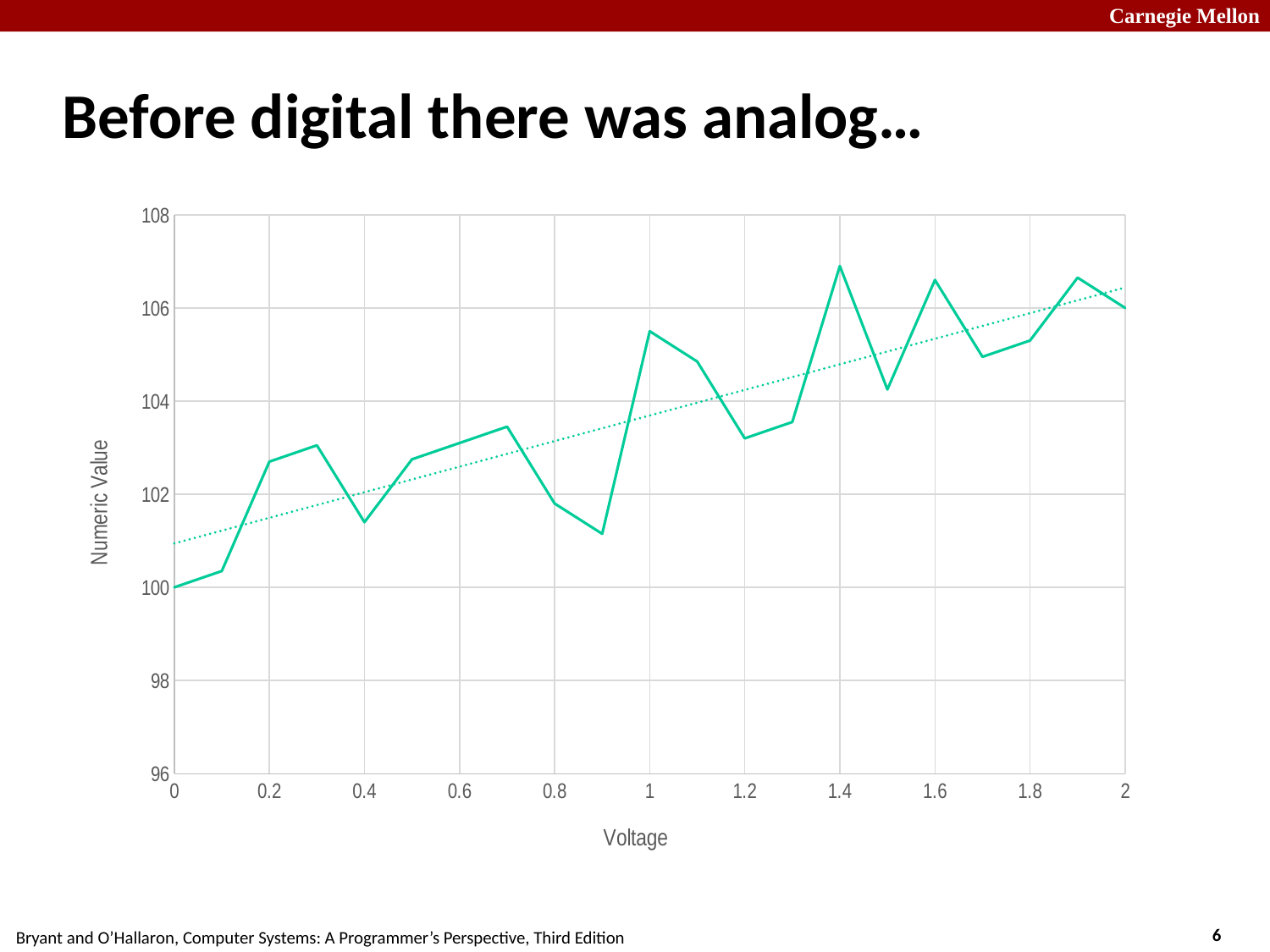
What is the Numeric Value at Voltage 0? 100 Is the Numeric Value at Voltage 1 greater or less than 104? greater Is the Numeric Value at Voltage 0.9 greater or less than 102? less Which has the larger Numeric Value, Voltage 0.3 or Voltage 0.4? 0.3 At which Voltage is the Numeric Value lowest? 0 What kind of chart is shown on the slide? line chart At which Voltage is the Numeric Value highest? 1.4 Is the Numeric Value at Voltage 0.4 greater or less than 102? less What is the label of the y axis? Numeric Value What is the label of the x axis? Voltage Overall, does the Numeric Value rise or fall as Voltage increases from 0 to 2? rise